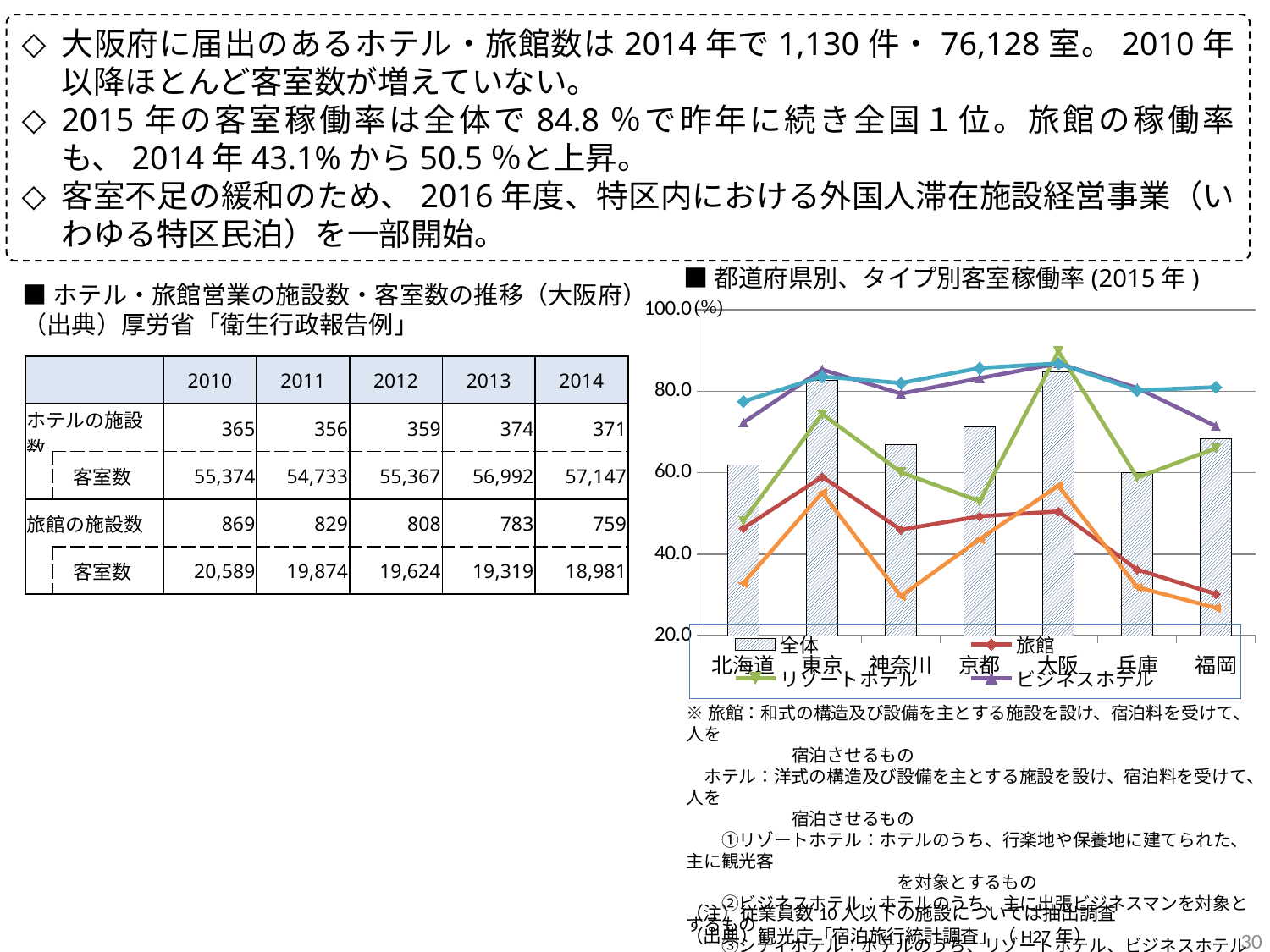
Which prefecture has the highest リゾートホテル value? 大阪 Is the ビジネスホテル value for 東京 greater or less than 80? greater Is the 全体 value for 大阪 greater or less than 80? greater What is the title of the chart? 都道府県別、タイプ別客室稼働率 (2015年) How many prefectures are shown on the x axis of the chart? 7 What unit is shown on the y axis of the chart? % Is the 旅館 value for 神奈川 greater or less than 60? less Which prefecture has the highest 旅館 value? 東京 In 大阪, which is larger, the ビジネスホテル value or the 旅館 value? ビジネスホテル What kind of chart is shown on the slide? bar and line chart Which prefecture has the lowest 旅館 value? 福岡